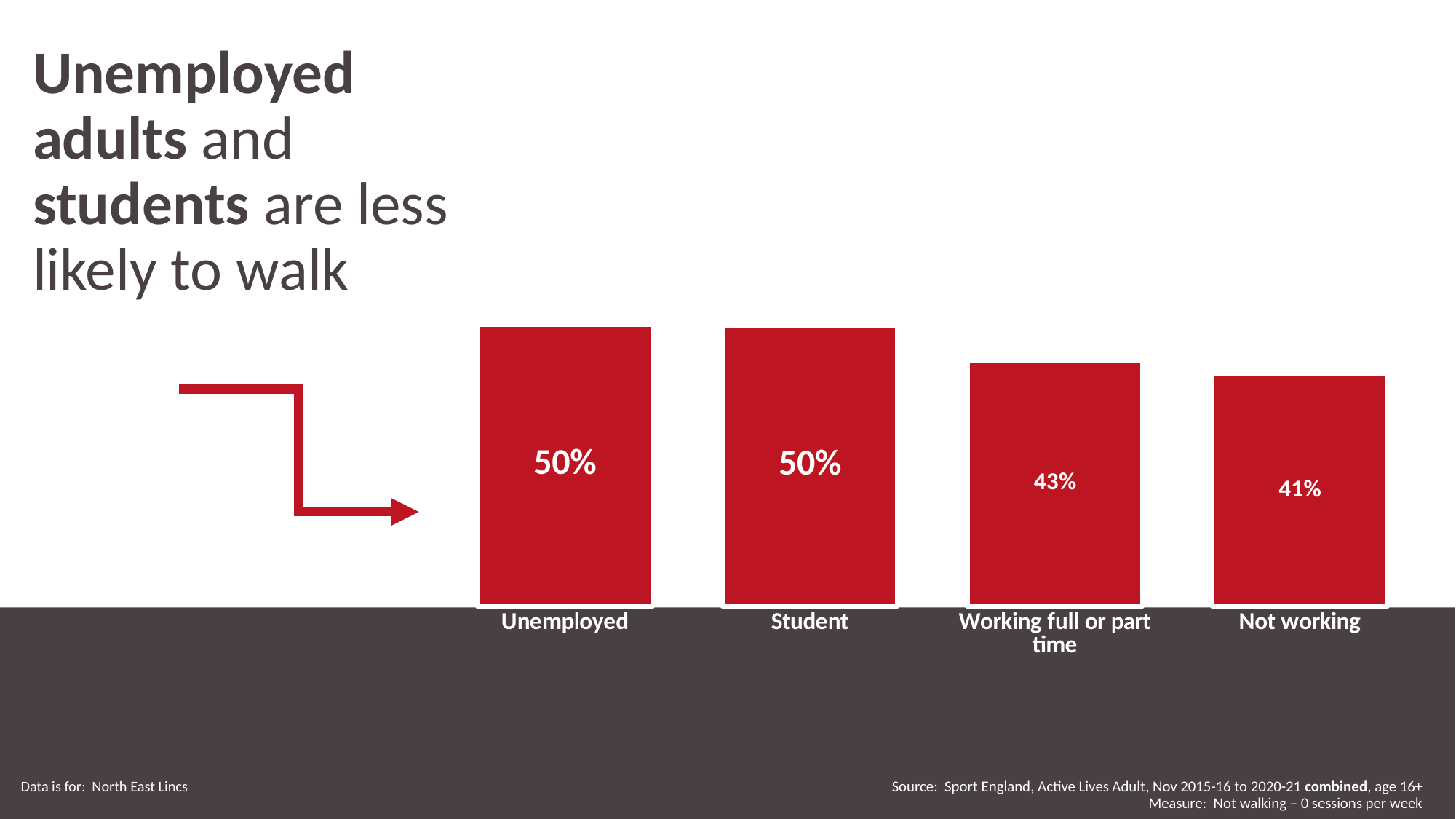
How many categories are shown in the chart? 4 What kind of chart is shown on the slide? Bar chart Which category has the lowest value? Not working What is the value for Not working? 41% What is the difference between the values for Working full or part time and Not working? 2% What measure does the chart show, according to the note at the bottom of the slide? Not walking – 0 sessions per week What is the difference between the values for Unemployed and Not working? 9% Do the values rise or fall from left to right across the categories? Fall What is the value for Unemployed? 50% What is the value for Student? 50% What is the value for Working full or part time? 43% Which is larger, the value for Student or the value for Working full or part time? Student